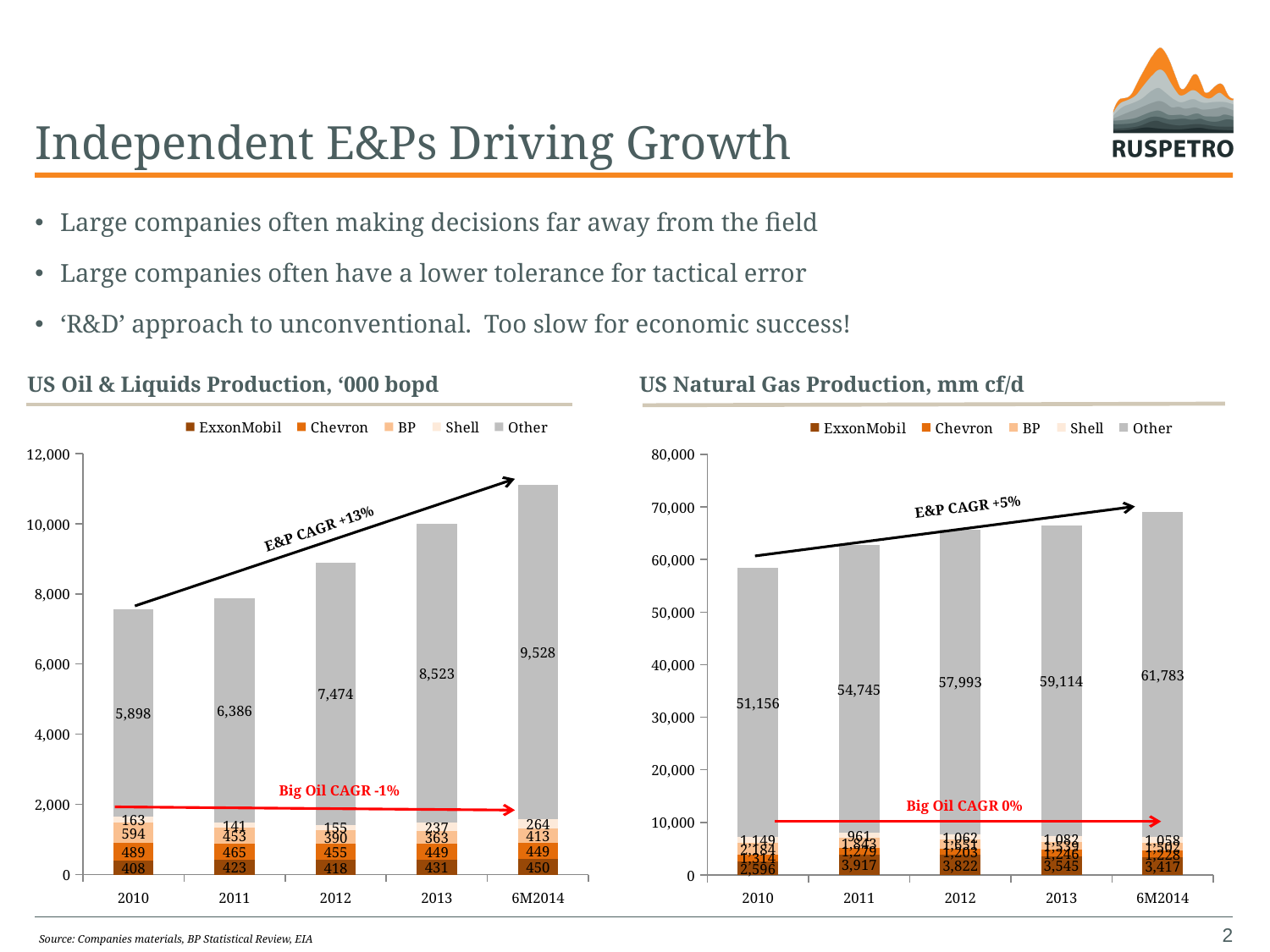
In the US Natural Gas Production chart, what is the difference between the Other value in 6M2014 and in 2010? 10,627 In the US Oil & Liquids Production chart, what is the value for Other in 2012? 7,474 In the US Oil & Liquids Production chart, what is the difference between the Other value in 6M2014 and in 2010? 3,630 In the US Natural Gas Production chart, what is the value for ExxonMobil in 2011? 3,917 How many series does the legend of the US Oil & Liquids Production chart list? 5 In the US Oil & Liquids Production chart, is the BP value larger in 2010 or in 2013? 2010 In the US Oil & Liquids Production chart, what is the total of the stacked bar for 2010? 7,552 In the US Oil & Liquids Production chart, what is the value for Shell in 6M2014? 264 In the US Natural Gas Production chart, do the Other values rise or fall from 2010 to 6M2014? rise In the US Oil & Liquids Production chart, which period has the highest value for Other? 6M2014 In the US Natural Gas Production chart, what is the value for Other in 2013? 59,114 In the US Oil & Liquids Production chart, what is the value for ExxonMobil in 2010? 408